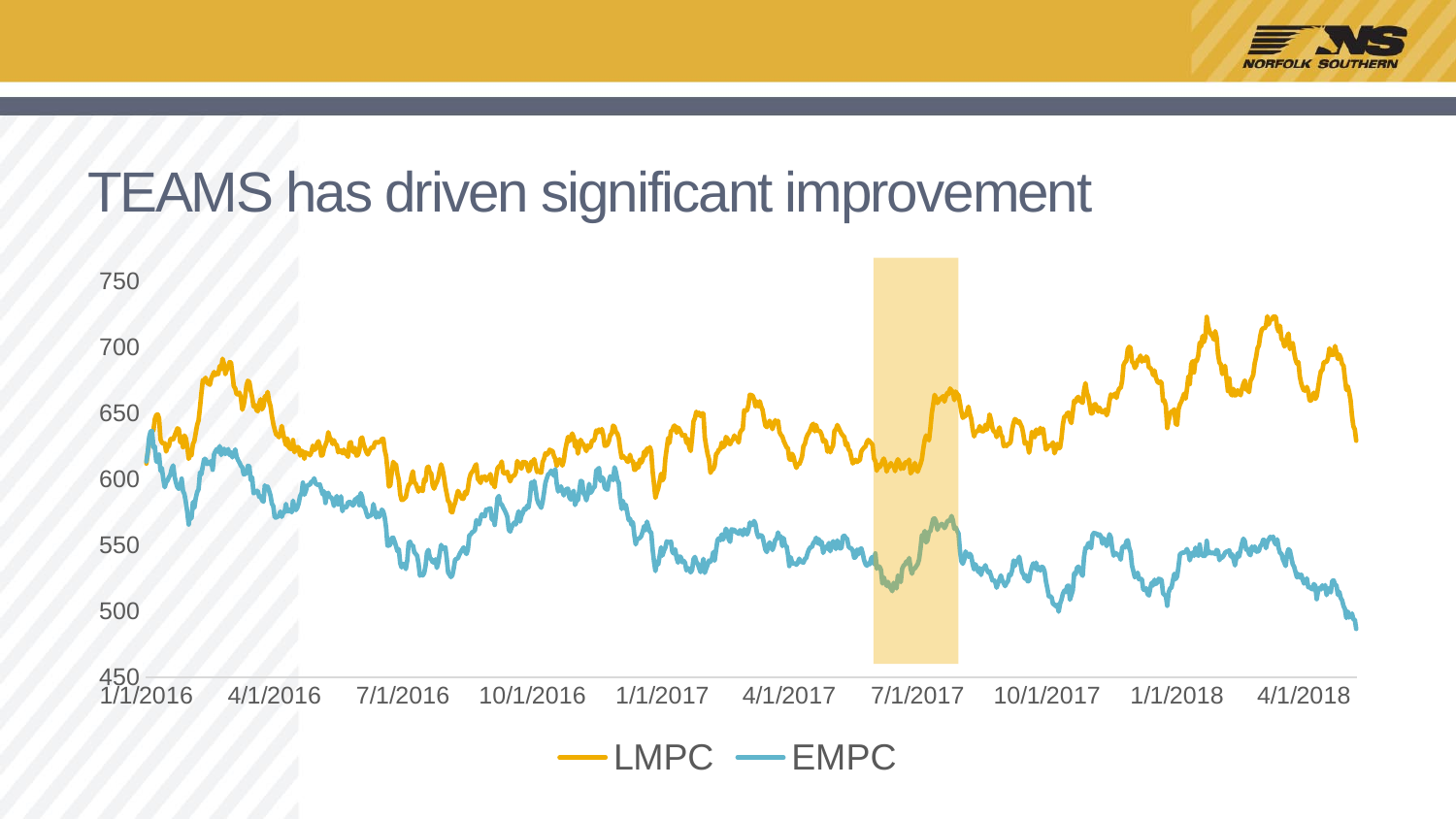
What kind of chart is shown on the slide? line chart What are the two series named in the legend? LMPC and EMPC Is the value for LMPC at 1/1/2018 greater or less than 650? greater How many series does the legend list? 2 Is the value for EMPC at 7/1/2017 greater or less than 550? less How many date labels are shown on the x axis? 10 Which series reaches the highest value shown on the chart? LMPC Which series reaches the lowest value shown on the chart? EMPC Is the value for EMPC at 4/1/2018 greater or less than 550? less Which series is plotted higher on the chart across the whole period, LMPC or EMPC? LMPC What is the title of the slide containing the chart? TEAMS has driven significant improvement Does the EMPC series generally rise or fall from 1/1/2016 to 4/1/2018? fall